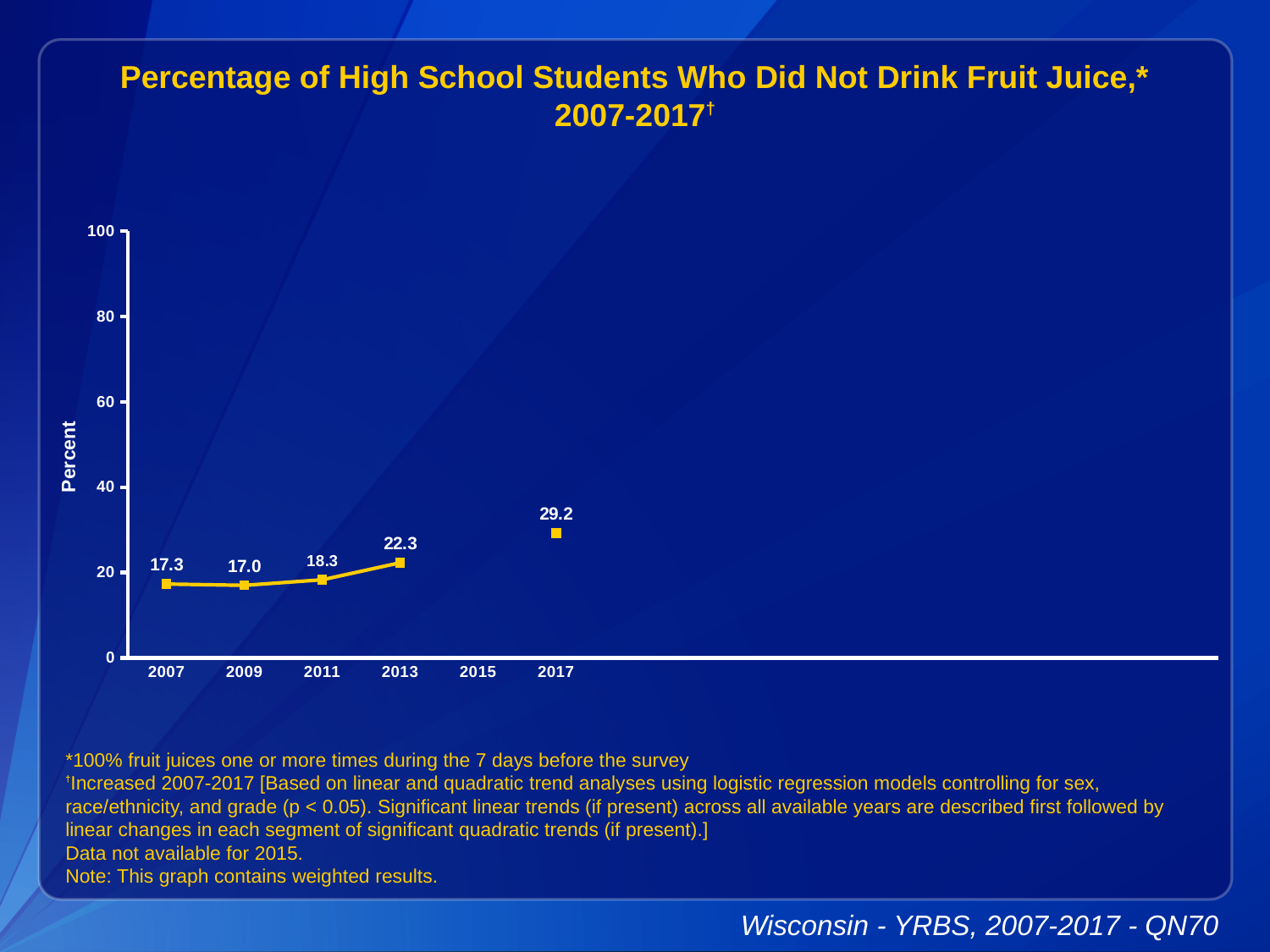
Which year has the highest value? 2017 What is the value for 2017? 29.2 What kind of chart is this? line chart Do the values generally rise or fall from 2007 to 2017? rise How many years have a plotted data point? 5 What is the value for 2007? 17.3 Which is larger, the value for 2011 or the value for 2013? 2013 What is the label on the y axis? Percent Is the value for 2017 greater or less than 40? less What is the value for 2013? 22.3 Which year has the lowest value? 2009 What is the difference between the values for 2017 and 2007? 11.9